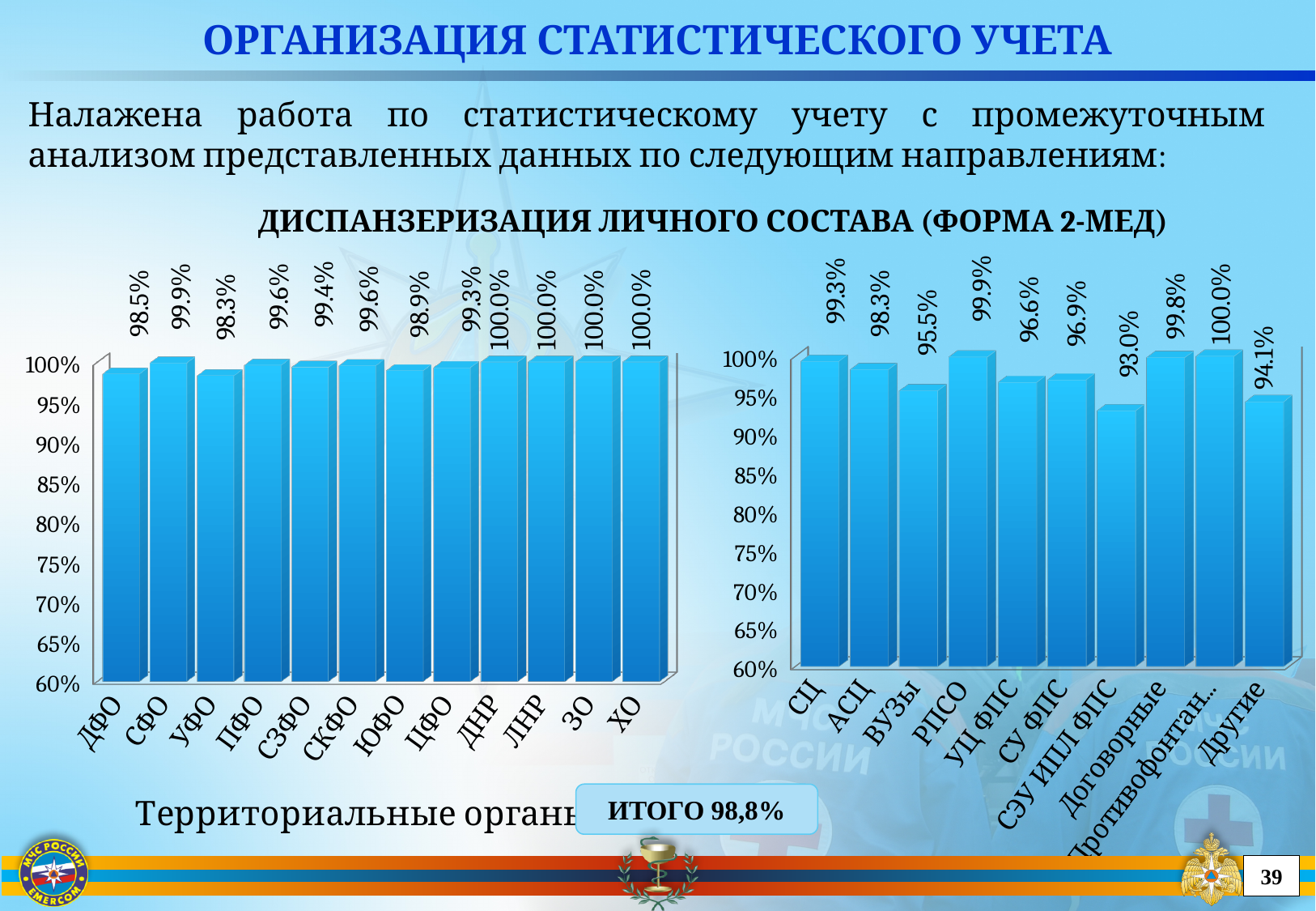
On the right chart, what is the difference between the values for РПСО and Другие? 5.8% On the right chart, what is the value for ВУЗы? 95.5% On the left chart, which is larger, the value for СФО or the value for ЮФО? СФО On the right chart, is the value for СЭУ ИПЛ ФПС greater or less than 95%? less On the left chart, what is the value for СЗФО? 99.4% On the right chart, what is the value for Договорные? 99.8% On the left chart, which category has the lowest value? УФО How many categories are shown on the right chart? 10 On the right chart, which category has the lowest value? СЭУ ИПЛ ФПС How many categories are shown on the left chart? 12 What type of chart is the left chart? bar chart On the left chart, what is the value for ДФО? 98.5%